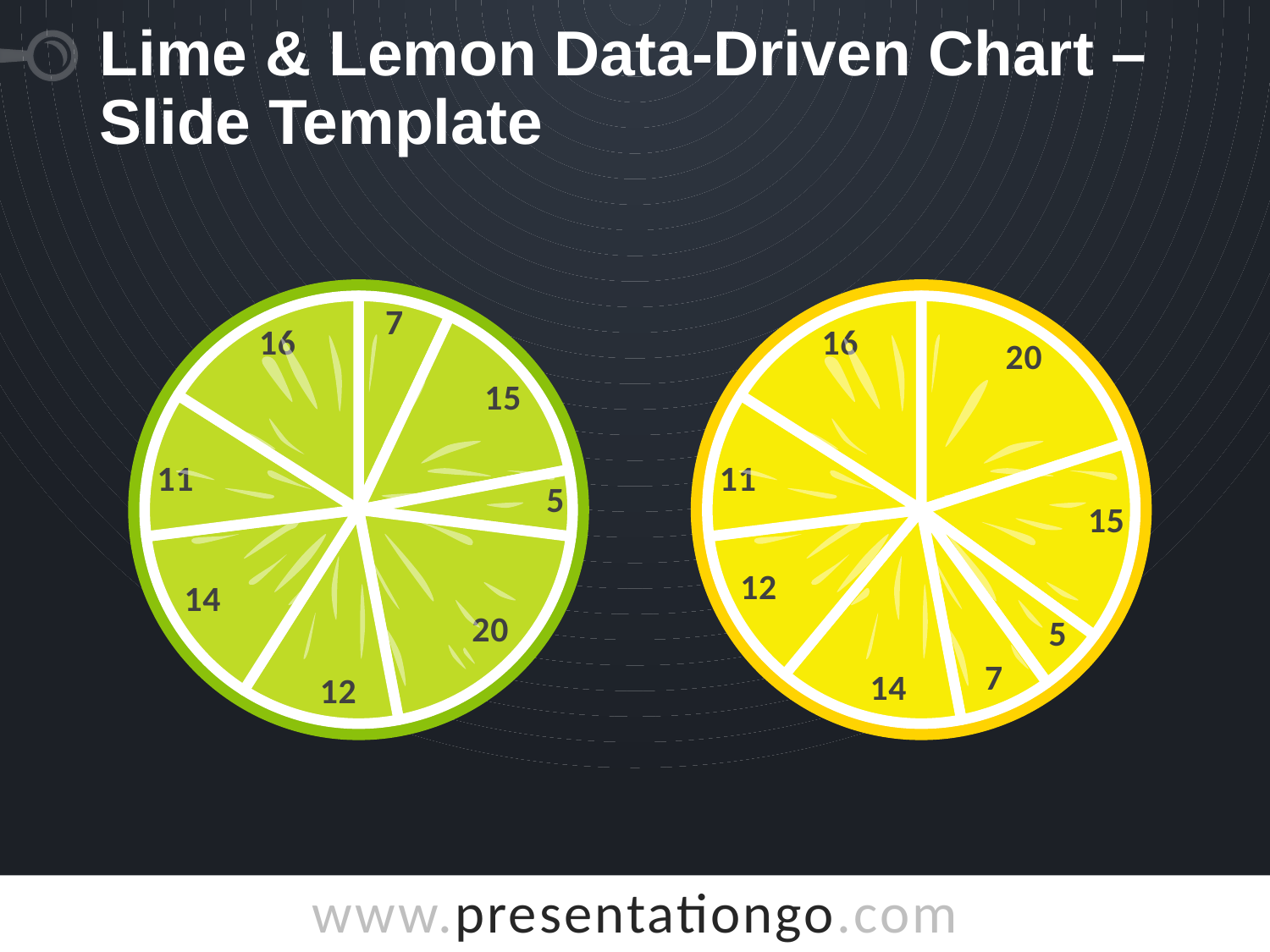
What kind of chart is the lime-shaped chart on the left? Pie chart What is the title of the slide containing the two pie charts? Lime & Lemon Data-Driven Chart – Slide Template In the lime chart on the left, what is the difference between the largest slice (20) and the smallest slice (5)? 15 In the lime chart on the left, what is the largest slice value? 20 In the lemon chart on the right, what is the smallest slice value? 5 How many slices does the lemon chart on the right have? 8 In the lime chart on the left, what is the smallest slice value? 5 What is the total of all slice values in the lime chart on the left? 100 In the lemon chart on the right, what is the largest slice value? 20 In the lemon chart on the right, what share of the whole pie does the slice labeled 20 represent? 20% What is the total of all slice values in the lemon chart on the right? 100 How many slices does the lime chart on the left have? 8